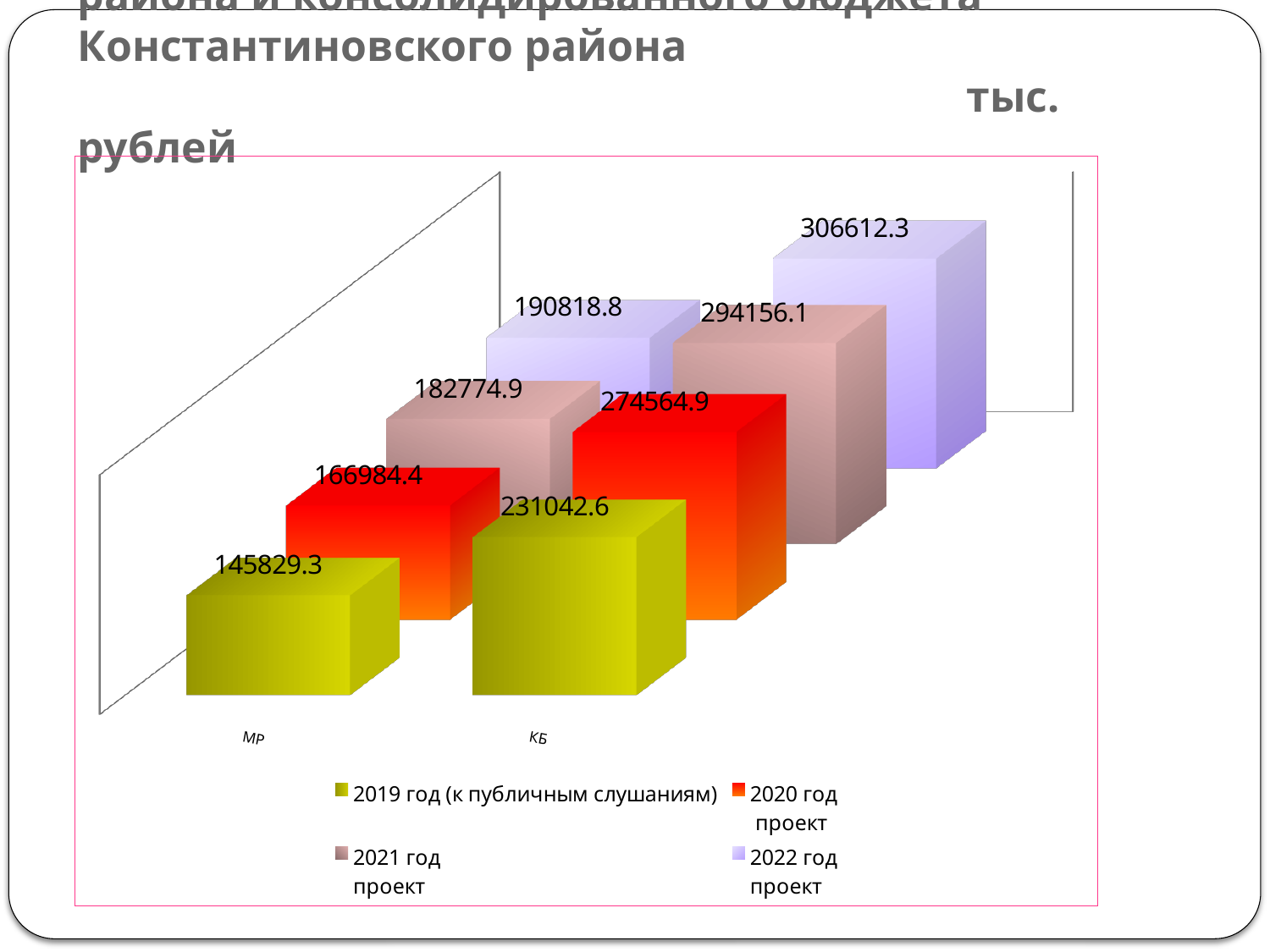
What is the value for КБ in the 2022 год проект series? 306612.3 Which is larger: the 2021 год проект value for МР or the 2019 год value for КБ? 2019 год value for КБ What is the difference between the КБ and МР values in the 2022 год проект series? 115793.5 What kind of chart is shown on the slide? Bar chart What is the difference between the 2020 год проект and 2019 год values for МР? 21155.1 How many categories are shown on the x axis? 2 Which series has the lowest value for МР? 2019 год (к публичным слушаниям) What is the value for КБ in the 2020 год проект series? 274564.9 What is the value for МР in the 2021 год проект series? 182774.9 What is the value for МР in the 2019 год (к публичным слушаниям) series? 145829.3 How many series does the legend list? 4 Which series has the highest value for КБ? 2022 год проект